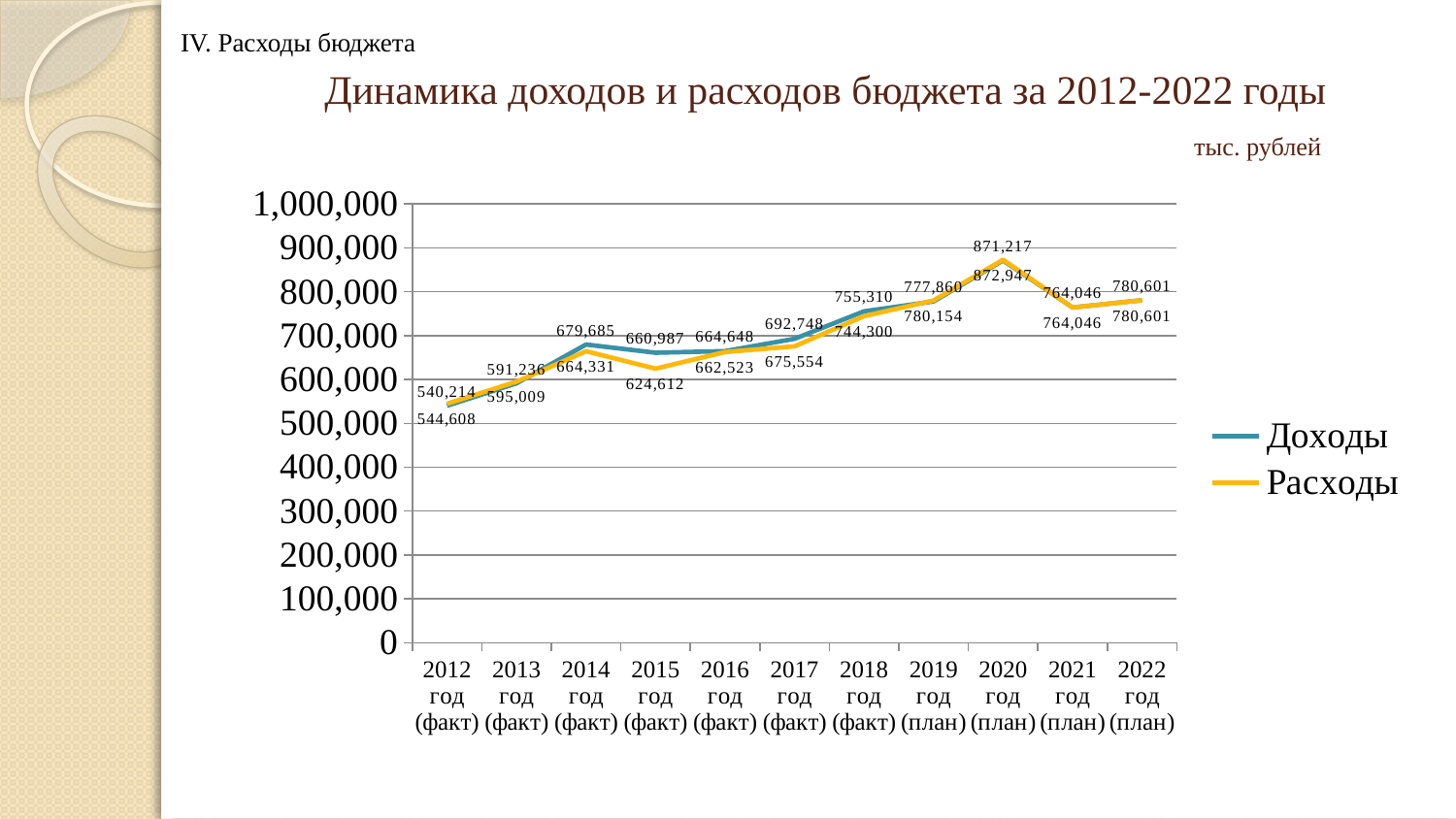
What unit is stated for the values in the chart? тыс. рублей What is the value of Расходы for 2022 год (план)? 780,601 What is the value of Доходы for 2020 год (план)? 871,217 In which year is Доходы highest? 2020 год (план) In which year is Расходы lowest? 2012 год (факт) Which is larger in 2014 год (факт), Доходы or Расходы? Доходы What is the difference between Доходы and Расходы in 2015 год (факт)? 36,375 Is the value of Доходы for 2018 год (факт) greater or less than 700,000? greater How many years (categories) are plotted along the x axis? 11 What is the value of Расходы for 2015 год (факт)? 624,612 How many series does the legend list? 2 What type of chart is shown on the slide? line chart